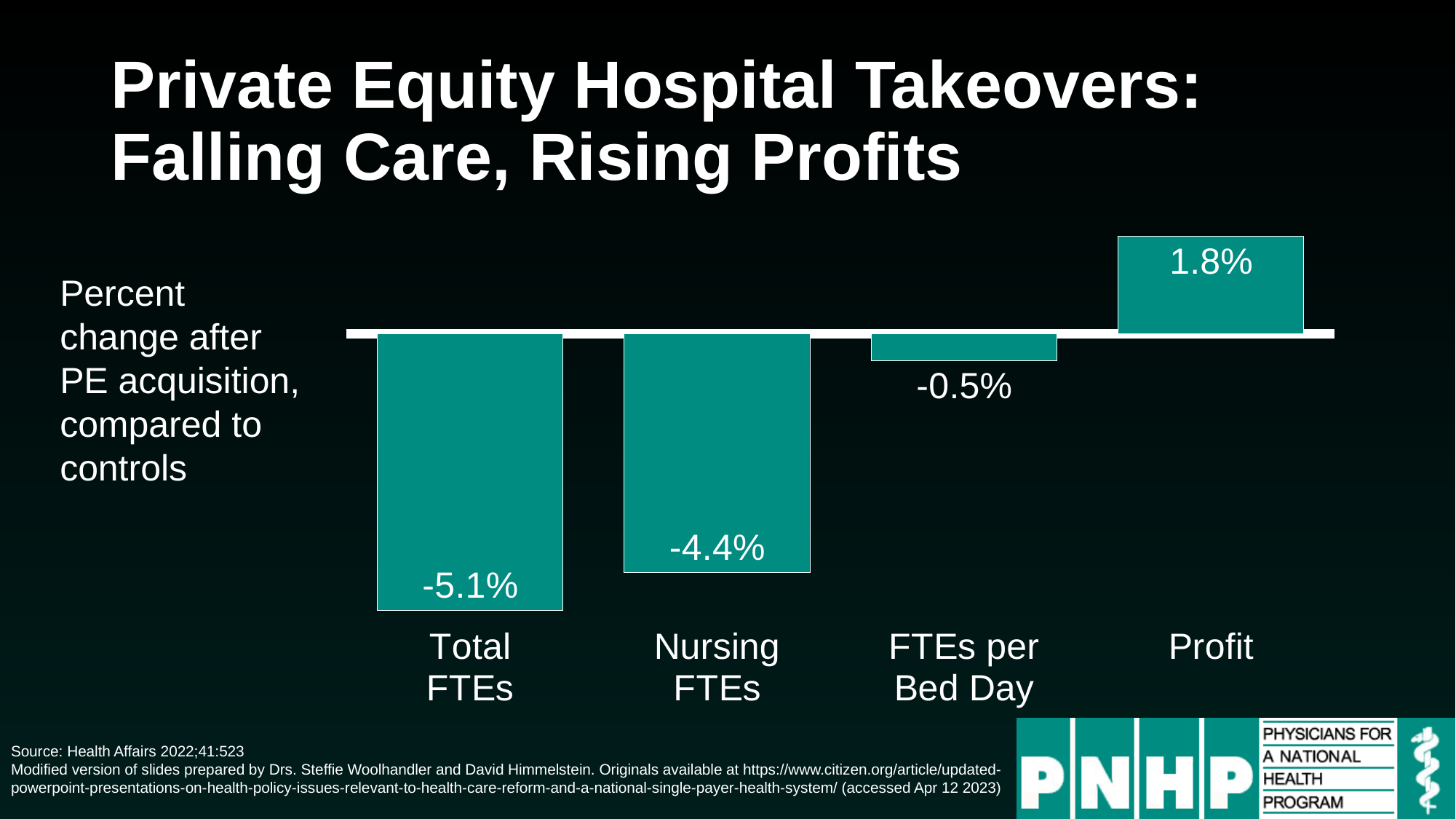
What is the percent change for Nursing FTEs? -4.4% How many categories have a negative percent change? 3 How many categories are shown in the chart? 4 What is the percent change for Total FTEs? -5.1% Which category has the highest value? Profit What is the difference between the values for Total FTEs and Nursing FTEs? 0.7% Which category has the lowest value? Total FTEs What is the percent change for FTEs per Bed Day? -0.5% What kind of chart is shown on the slide? Bar chart What is the percent change for Profit? 1.8% What is the difference between the values for Profit and FTEs per Bed Day? 2.3% Which is larger, the value for Nursing FTEs or the value for FTEs per Bed Day? FTEs per Bed Day